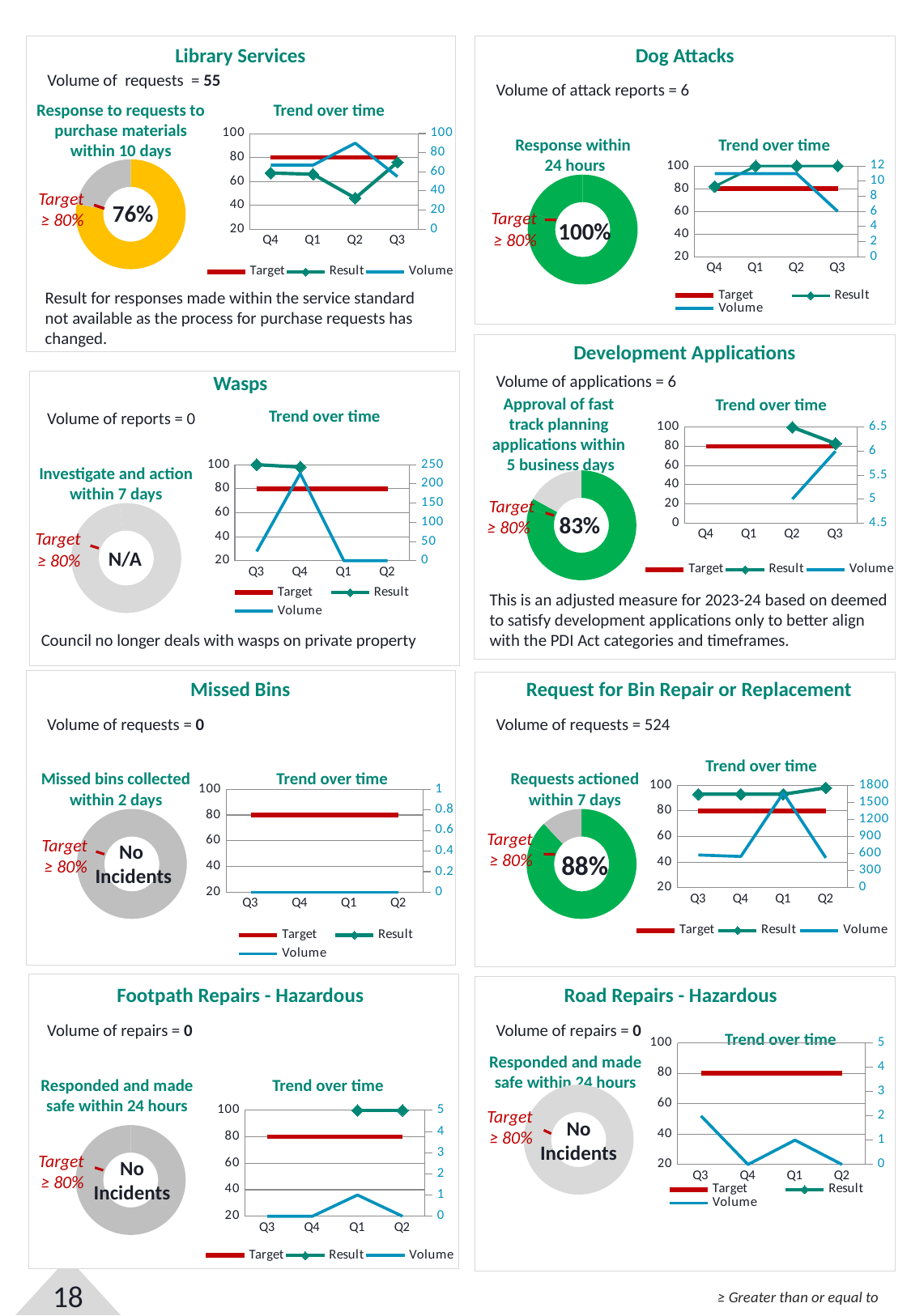
In the Library Services 'Response to requests to purchase materials within 10 days' donut chart, what percentage is shown in the centre? 76% What kind of chart is the Library Services 'Response to requests to purchase materials within 10 days' chart? Pie (donut) chart Which donut chart shows the larger percentage: Development Applications or Request for Bin Repair or Replacement? Request for Bin Repair or Replacement In the Dog Attacks 'Trend over time' chart, at what level on the left axis is the Target line drawn? 80 How many quarters are shown on the x axis of the Request for Bin Repair or Replacement 'Trend over time' chart? 4 What is the difference between the Dog Attacks donut percentage and the Library Services donut percentage? 24% In the Development Applications 'Approval of fast track planning applications within 5 business days' donut chart, what percentage is shown? 83% In the Request for Bin Repair or Replacement 'Requests actioned within 7 days' donut chart, what percentage is shown? 88% In the Library Services 'Trend over time' chart, is the Result value for Q2 greater or less than 60? less How many series does the legend of the Library Services 'Trend over time' chart list? 3 In the Wasps 'Investigate and action within 7 days' donut chart, what is shown in the centre? N/A In the Dog Attacks 'Response within 24 hours' donut chart, what percentage is shown in the centre? 100%